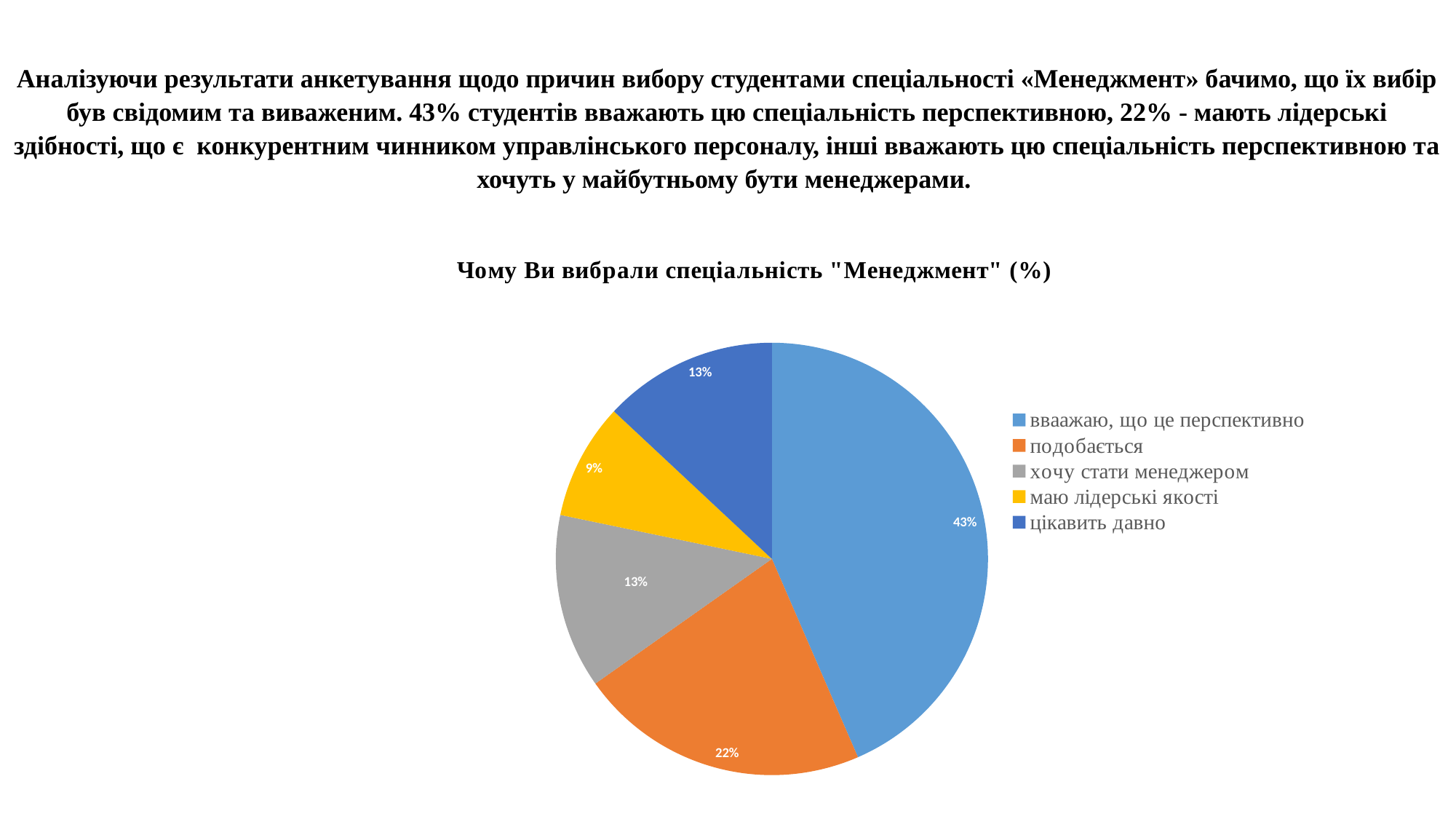
Which category has the smallest slice of the pie? маю лідерські якості What share of the pie is labelled for "маю лідерські якості"? 9% What share of the pie is labelled for "цікавить давно"? 13% Which is larger, the share for "подобається" or the share for "хочу стати менеджером"? подобається What share of the pie is labelled for "подобається"? 22% What is the title of the chart? Чому Ви вибрали спеціальність "Менеджмент" (%) What kind of chart is shown on the slide? pie chart What is the difference between the shares for "вваажаю, що це перспективно" and "подобається"? 21% How many categories does the legend list? 5 What share of the pie is labelled for "вваажаю, що це перспективно"? 43% Which category has the largest slice of the pie? вваажаю, що це перспективно What colour is the slice for "маю лідерські якості"? yellow